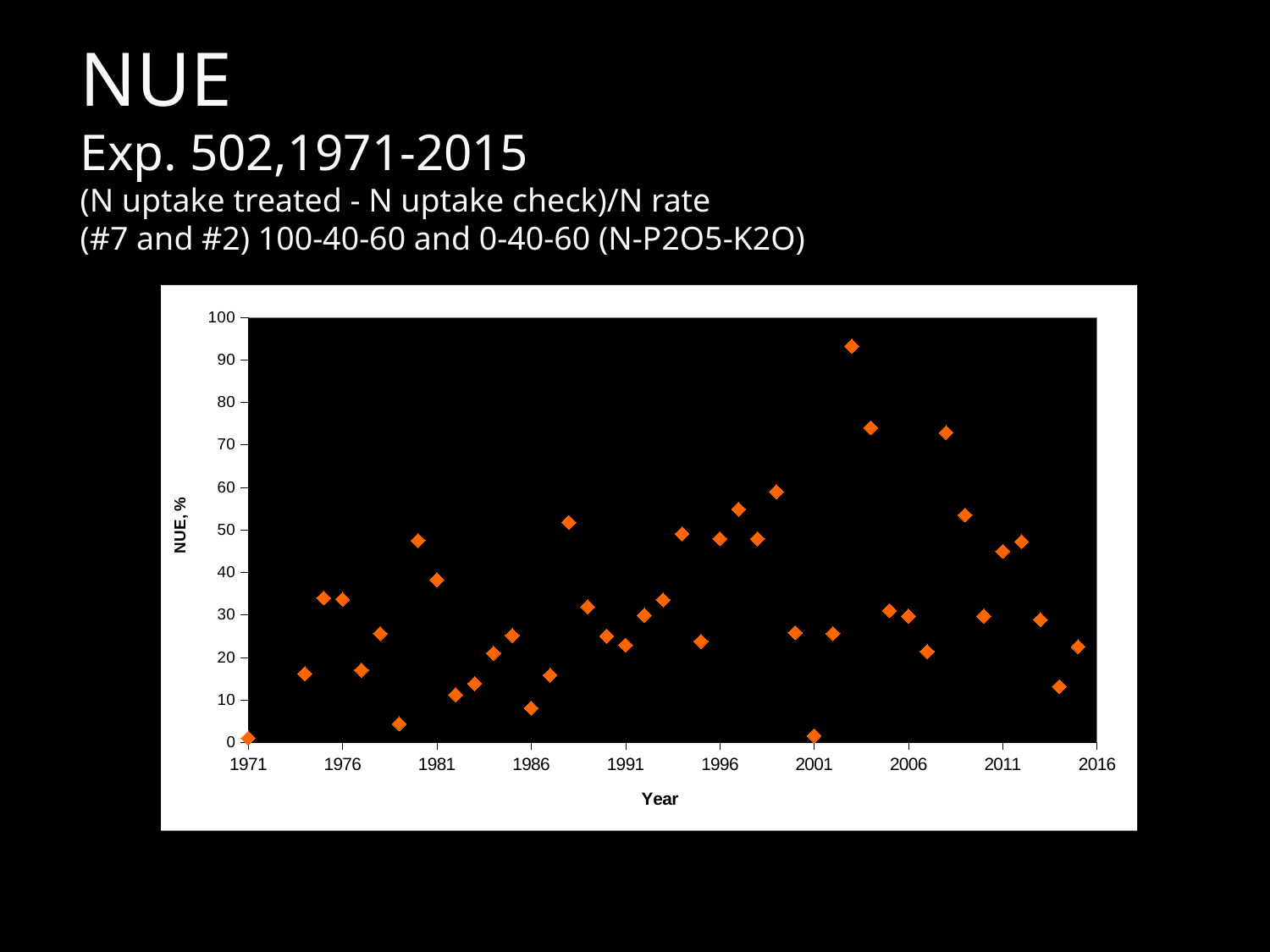
What kind of chart is shown on the slide? scatter chart Is the value for 1996 greater or less than 40? greater Is the value for 2011 greater or less than 40? greater Is the value for 1976 greater or less than 20? greater What is the label of the horizontal axis? Year What is the label of the vertical axis? NUE, %